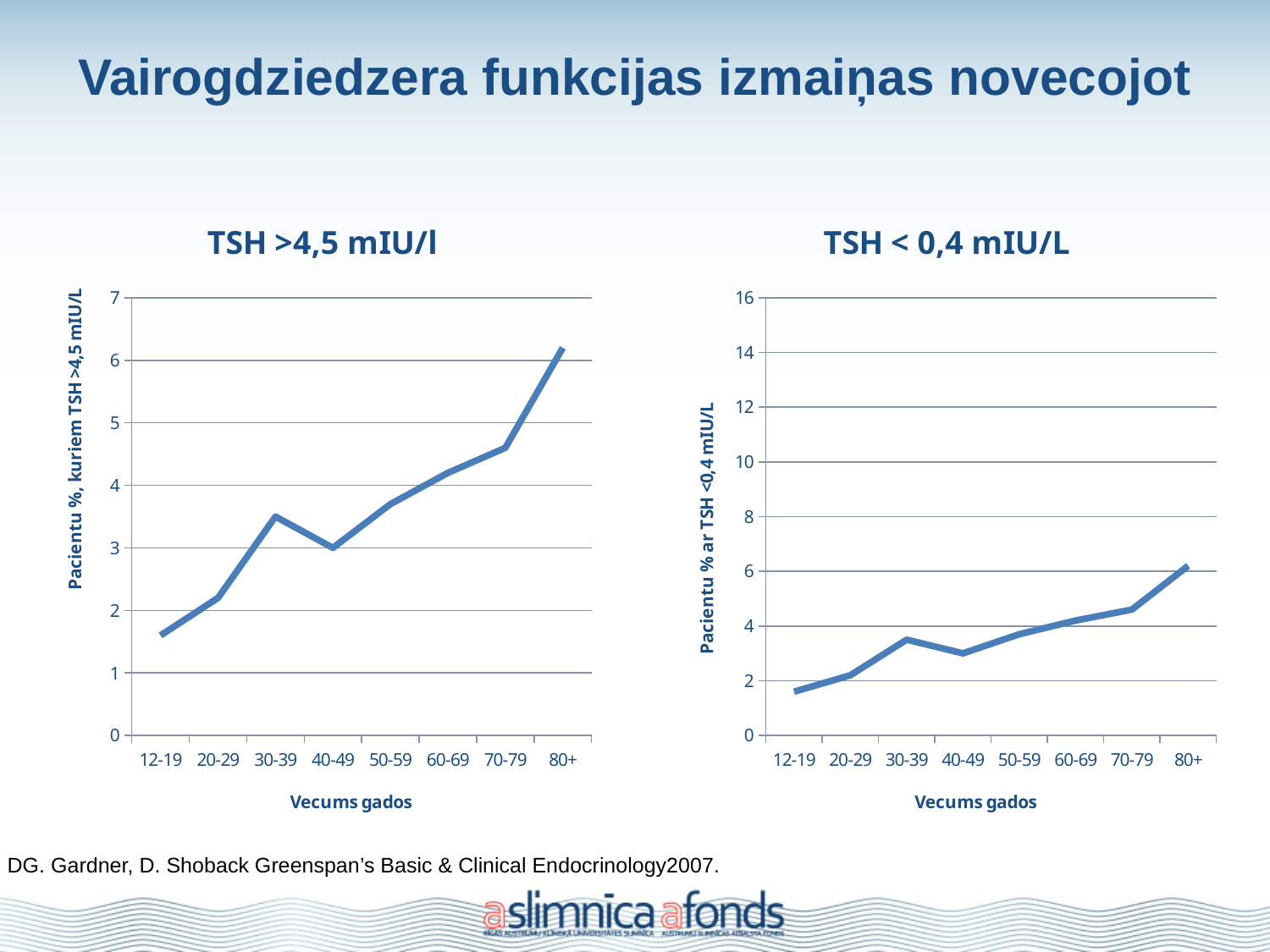
In the chart titled "TSH >4,5 mIU/l", which age group has the lowest value? 12-19 What is the x-axis title of the chart titled "TSH < 0,4 mIU/L"? Vecums gados What kind of chart is the chart titled "TSH < 0,4 mIU/L"? line chart In the chart titled "TSH < 0,4 mIU/L", which age group has the highest value? 80+ In the chart titled "TSH >4,5 mIU/l", which age group has the highest value? 80+ In the chart titled "TSH < 0,4 mIU/L", which age group has the lowest value? 12-19 In the chart titled "TSH >4,5 mIU/l", is the value for the 80+ age group greater or less than 6? greater In the chart titled "TSH >4,5 mIU/l", which is larger, the value for 30-39 or the value for 40-49? 30-39 In the chart titled "TSH < 0,4 mIU/L", is the value for the 12-19 age group greater or less than 2? less In the chart titled "TSH >4,5 mIU/l", how many age groups are shown on the x axis? 8 What kind of chart is the chart titled "TSH >4,5 mIU/l"? line chart In the chart titled "TSH < 0,4 mIU/L", how many age groups are shown on the x axis? 8